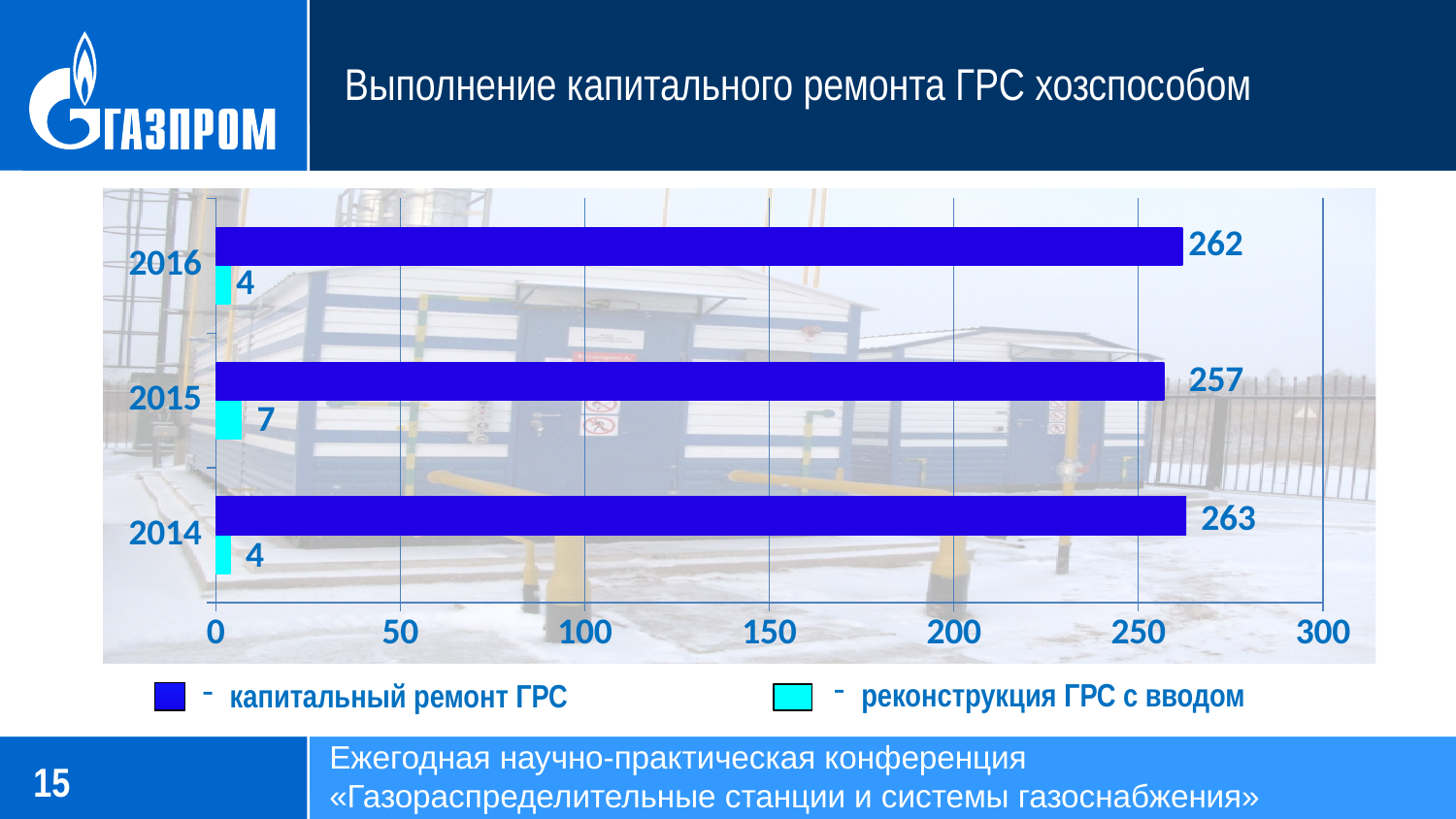
Which is larger: капитальный ремонт ГРС in 2016 or in 2015? 2016 How many years are shown on the chart? 3 What kind of chart is shown on the slide? bar chart What is the value for капитальный ремонт ГРС in 2014? 263 What is the difference between капитальный ремонт ГРС in 2014 and in 2015? 6 How many series does the legend list? 2 Which year has the lowest value for капитальный ремонт ГРС? 2015 What is the value for реконструкция ГРС с вводом in 2015? 7 Which year has the highest value for капитальный ремонт ГРС? 2014 What is the value for капитальный ремонт ГРС in 2016? 262 What is the title of the slide? Выполнение капитального ремонта ГРС хозспособом Which year has the highest value for реконструкция ГРС с вводом? 2015